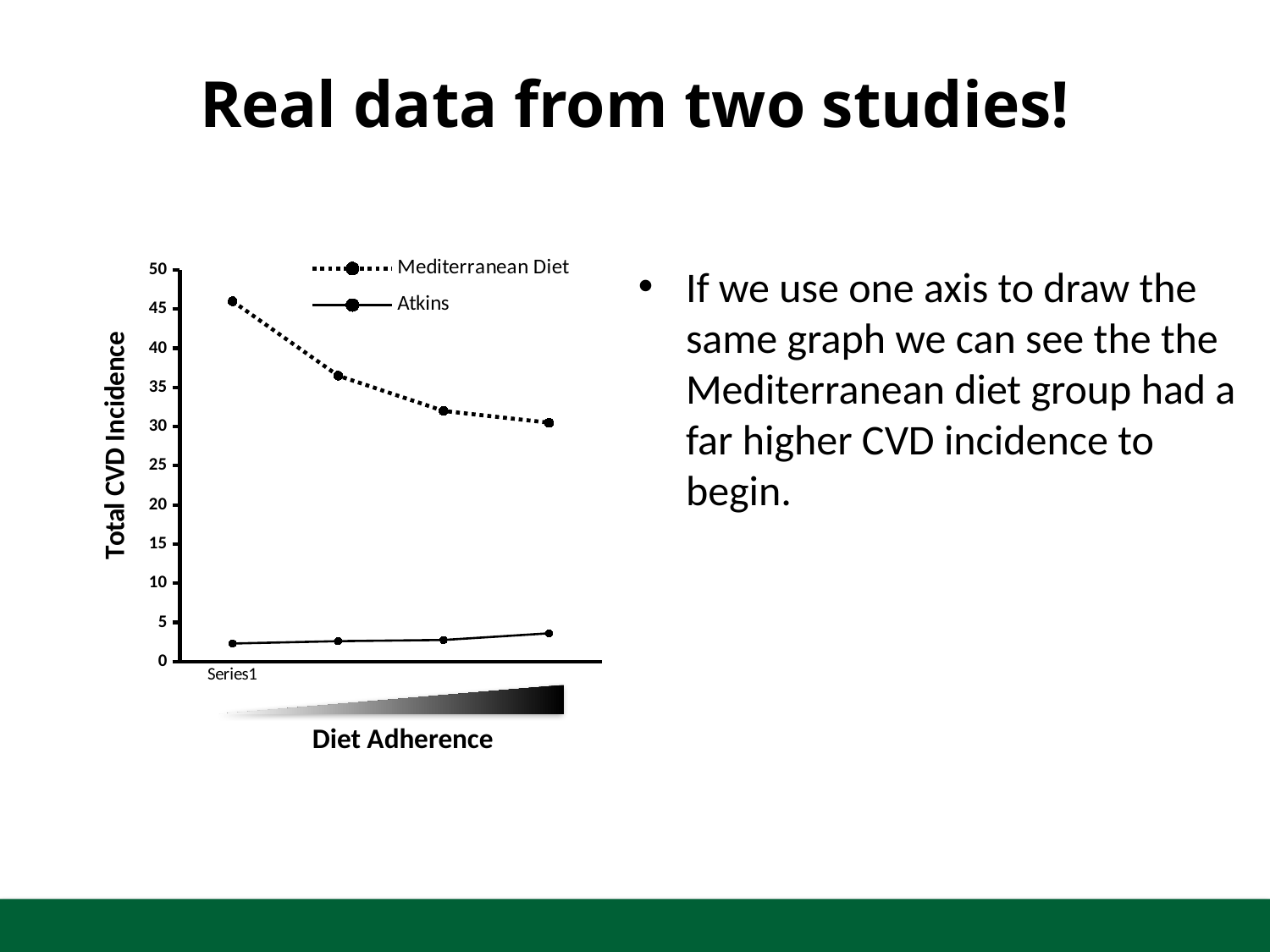
Do the values for the Atkins series rise or fall along the x axis? rise How many series does the legend list? 2 How many data points are plotted for the Mediterranean Diet series? 4 Is the first value for the Mediterranean Diet series greater or less than 40? greater What kind of chart is shown on the slide? line chart What is the title of the vertical axis? Total CVD Incidence Is the first value for the Atkins series greater or less than 5? less Which series has the higher value at the first point on the x axis, Mediterranean Diet or Atkins? Mediterranean Diet Do the values for the Mediterranean Diet series rise or fall along the x axis? fall Which series is drawn with a dotted line? Mediterranean Diet Is the second value for the Mediterranean Diet series greater or less than 40? less